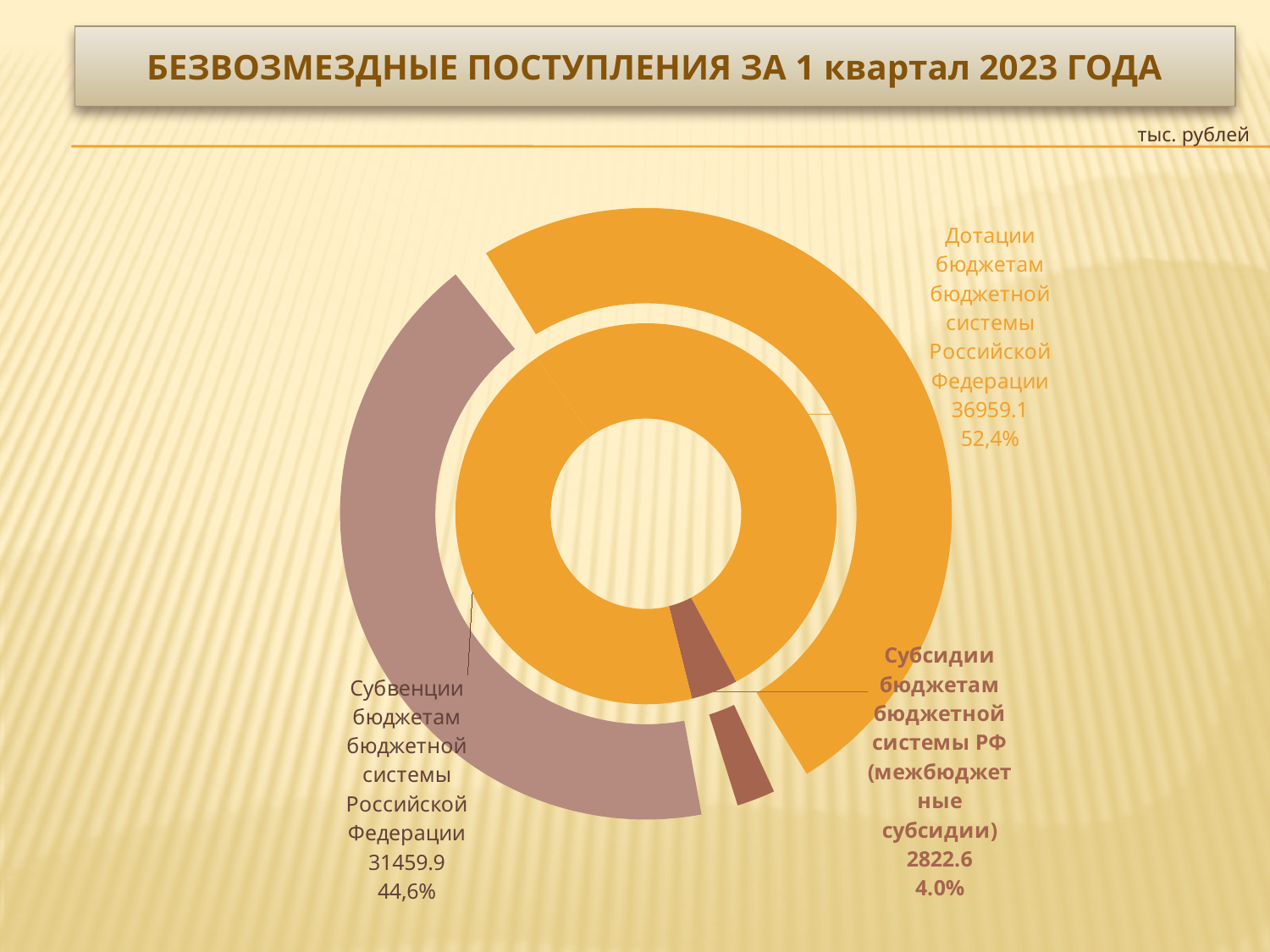
What share of the chart do Субсидии бюджетам бюджетной системы РФ (межбюджетные субсидии) represent? 4.0% What type of chart is shown on the slide? Doughnut chart What is the value for Субвенции бюджетам бюджетной системы Российской Федерации? 31459.9 What is the difference between the values for Дотации and Субвенции? 5499.2 What is the value for Дотации бюджетам бюджетной системы Российской Федерации? 36959.1 Which category has the largest value? Дотации бюджетам бюджетной системы Российской Федерации How many categories are shown in the chart? 3 What share of the chart do Дотации бюджетам бюджетной системы Российской Федерации represent? 52,4% Which category has the smallest value? Субсидии бюджетам бюджетной системы РФ (межбюджетные субсидии) Which is larger, the value for Субвенции or the value for Субсидии? Субвенции What is the difference between the values for Субвенции and Субсидии? 28637.3 What is the value for Субсидии бюджетам бюджетной системы РФ (межбюджетные субсидии)? 2822.6